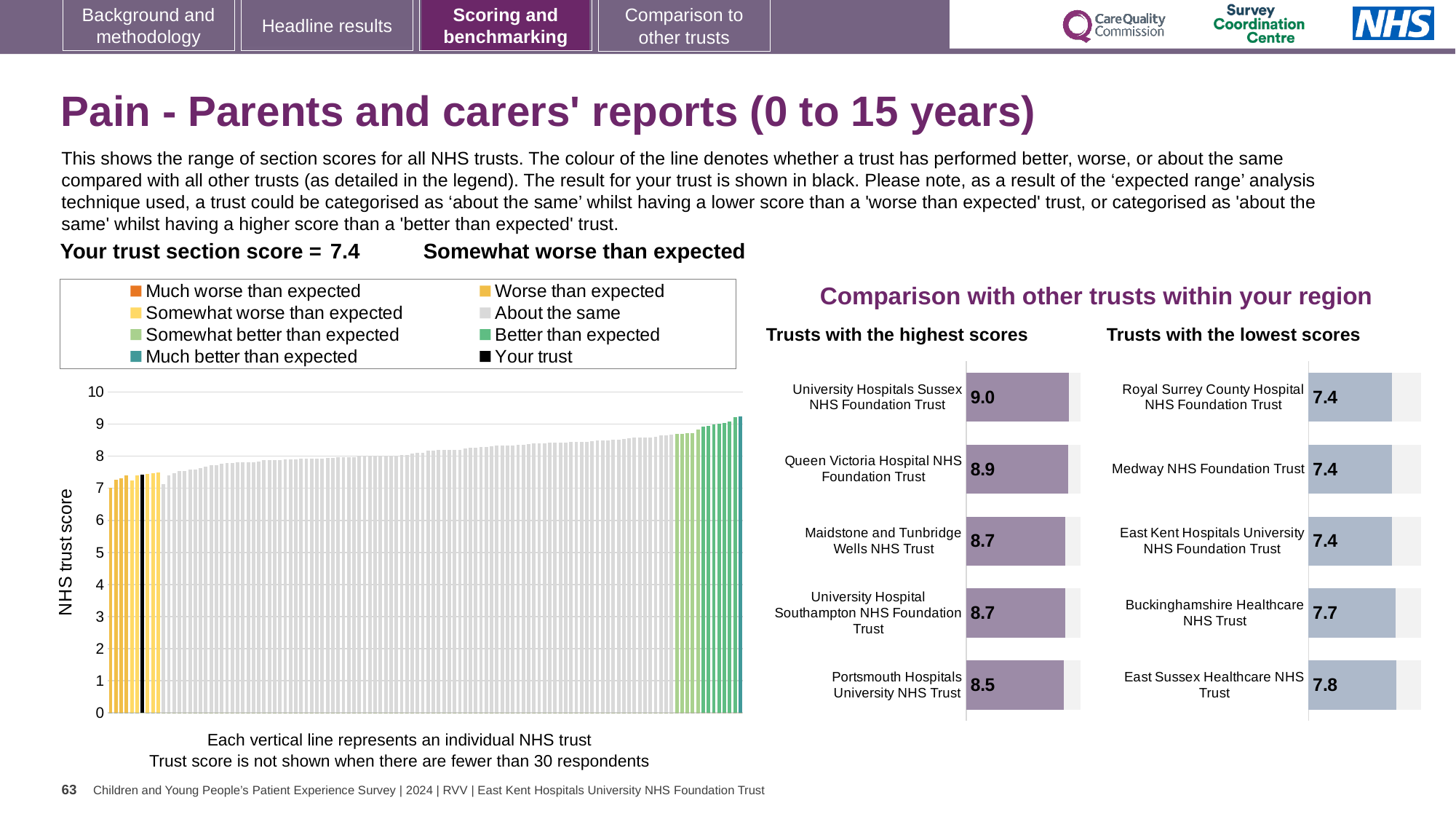
In the 'Trusts with the highest scores' chart, what is the score for Portsmouth Hospitals University NHS Trust? 8.5 What kind of chart is the large chart on the left showing NHS trust scores? Bar chart In the 'Trusts with the highest scores' chart, what is the difference between the scores of University Hospitals Sussex NHS Foundation Trust and Portsmouth Hospitals University NHS Trust? 0.5 In the 'Trusts with the lowest scores' chart, what is the score for Buckinghamshire Healthcare NHS Trust? 7.7 In the 'Trusts with the highest scores' chart, which has the larger score: Queen Victoria Hospital NHS Foundation Trust or Maidstone and Tunbridge Wells NHS Trust? Queen Victoria Hospital NHS Foundation Trust In the 'Trusts with the highest scores' chart, which trust has the highest score? University Hospitals Sussex NHS Foundation Trust In the 'Trusts with the lowest scores' chart, what is the difference between the scores of East Sussex Healthcare NHS Trust and Royal Surrey County Hospital NHS Foundation Trust? 0.4 In the 'Trusts with the lowest scores' chart, which trust has the highest score? East Sussex Healthcare NHS Trust How many entries does the legend above the left-hand chart list? 8 In the 'Trusts with the highest scores' chart, what is the score for University Hospitals Sussex NHS Foundation Trust? 9.0 How many trusts are shown in the 'Trusts with the lowest scores' chart? 5 In the left-hand chart of NHS trust scores, do the values rise or fall from left to right? Rise